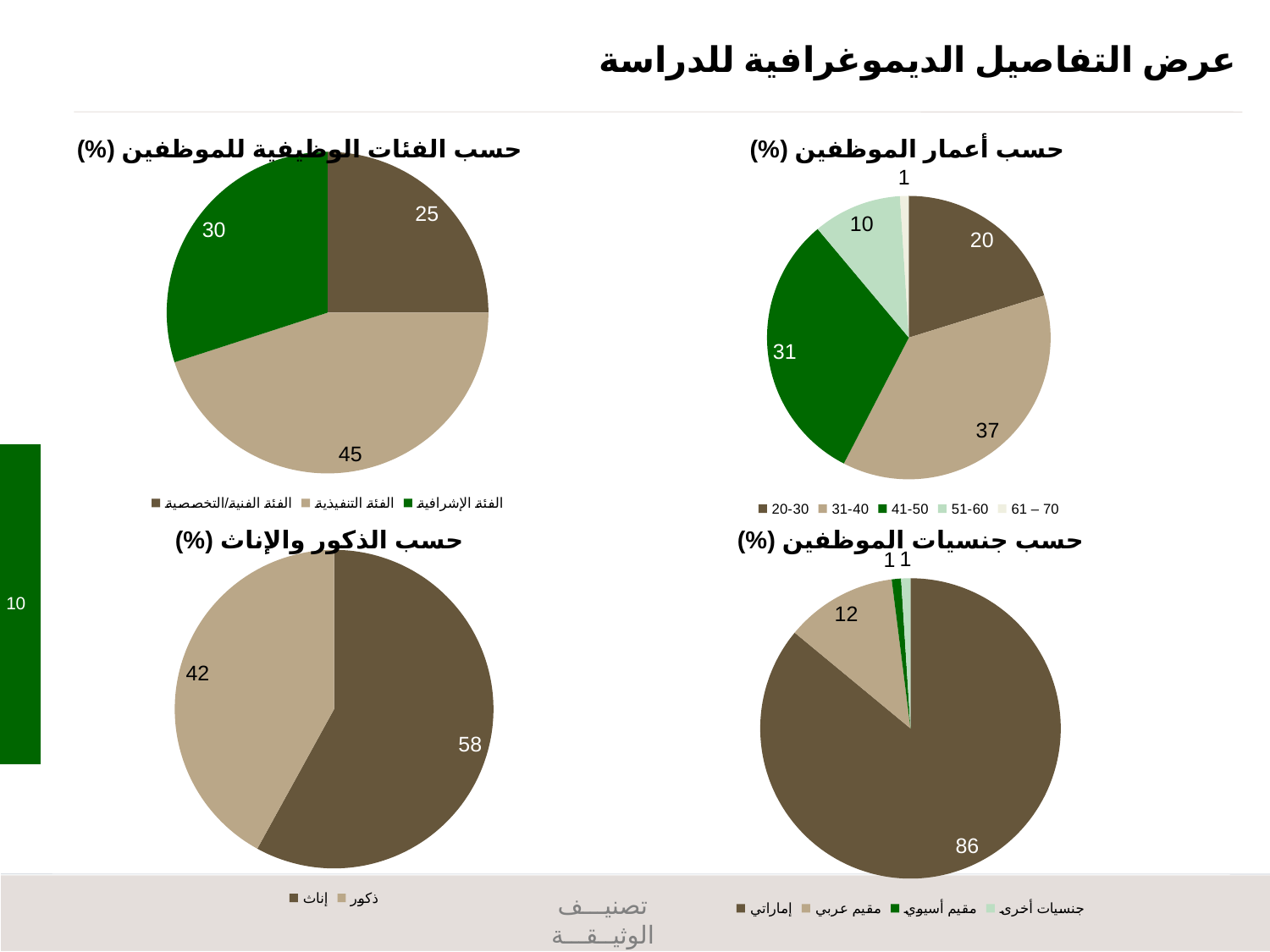
In the chart titled 'حسب أعمار الموظفين (%)', how many age groups are shown? 5 In the chart titled 'حسب أعمار الموظفين (%)', what is the value for the 31-40 age group? 37 In the chart titled 'حسب الذكور والإناث (%)', what is the difference between ذكور and إناث? 16 What type of chart is used for 'حسب جنسيات الموظفين (%)'? Pie chart In the chart titled 'حسب أعمار الموظفين (%)', which age group has the smallest share? 61 – 70 In the chart titled 'حسب الفئات الوظيفية للموظفين (%)', which is larger: الفئة الفنية/التخصصية or الفئة الإشرافية? الفئة الإشرافية In the chart titled 'حسب جنسيات الموظفين (%)', what is the value for مقيم عربي? 12 In the chart titled 'حسب الفئات الوظيفية للموظفين (%)', which category has the smallest share? الفئة الفنية/التخصصية In the chart titled 'حسب أعمار الموظفين (%)', which age group has the largest share? 31-40 In the chart titled 'حسب أعمار الموظفين (%)', what is the difference between the 41-50 and 51-60 values? 21 In the chart titled 'حسب الذكور والإناث (%)', what is the value for ذكور? 42 In the chart titled 'حسب الفئات الوظيفية للموظفين (%)', what is the value for الفئة التنفيذية? 45